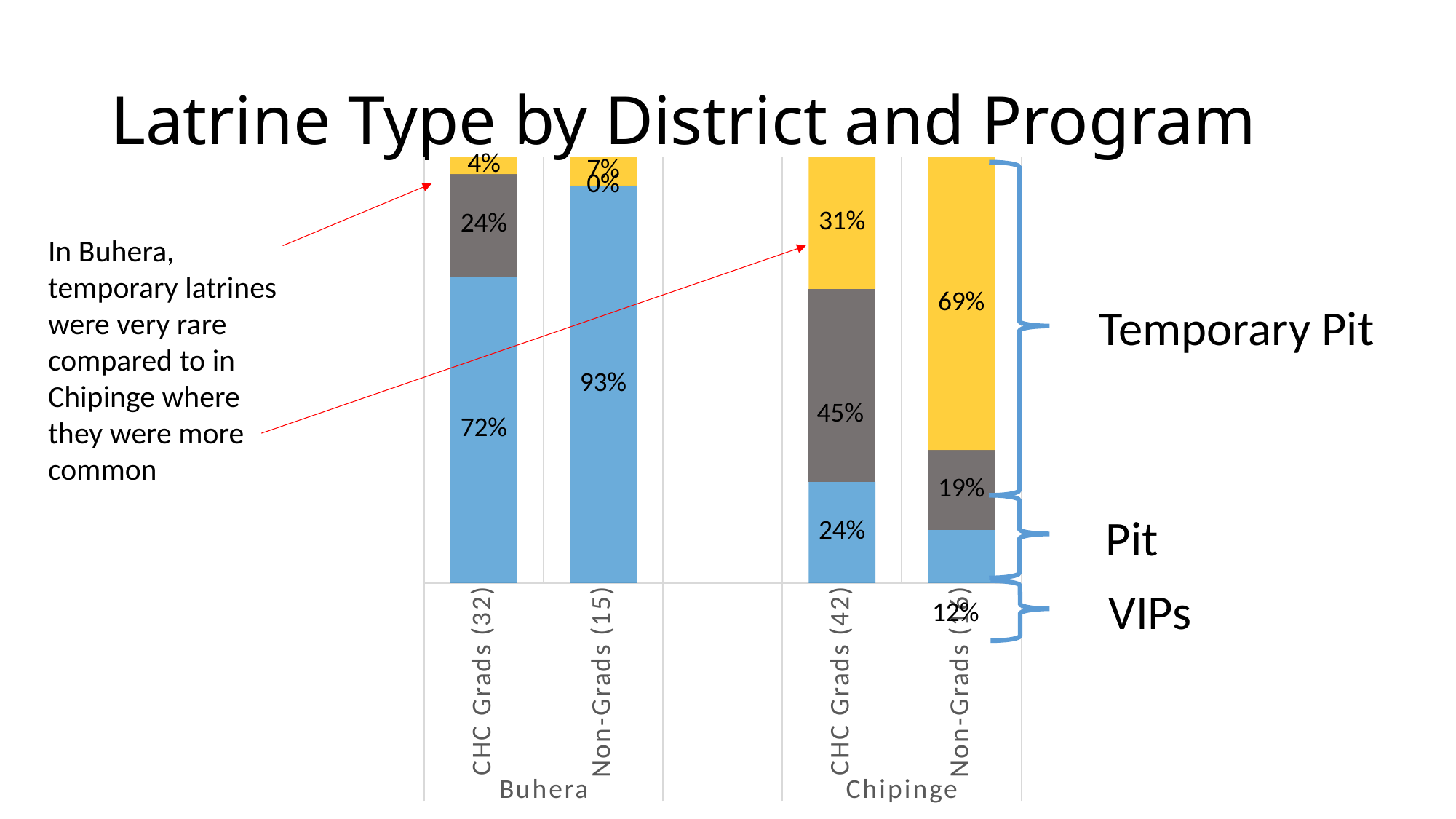
How many bars are plotted in the chart? 4 What kind of chart is shown on the slide? Stacked bar chart How many latrine types (series) does the chart show? 3 What is the title of the chart? Latrine Type by District and Program Which group has the highest share of VIPs latrines? Non-Grads (15) in Buhera By how many percentage points does the Temporary Pit share for CHC Grads (42) in Chipinge exceed that for CHC Grads (32) in Buhera? 27 percentage points Which has a larger Pit share: CHC Grads (42) in Chipinge or CHC Grads (32) in Buhera? CHC Grads (42) in Chipinge What percentage of latrines for CHC Grads (42) in Chipinge are Pit? 45% What percentage of latrines for Non-Grads in Chipinge are Temporary Pit? 69% Which group has the highest share of Temporary Pit latrines? Non-Grads in Chipinge What percentage of latrines for Non-Grads (15) in Buhera are Pit? 0% What percentage of latrines for CHC Grads (32) in Buhera are VIPs? 72%